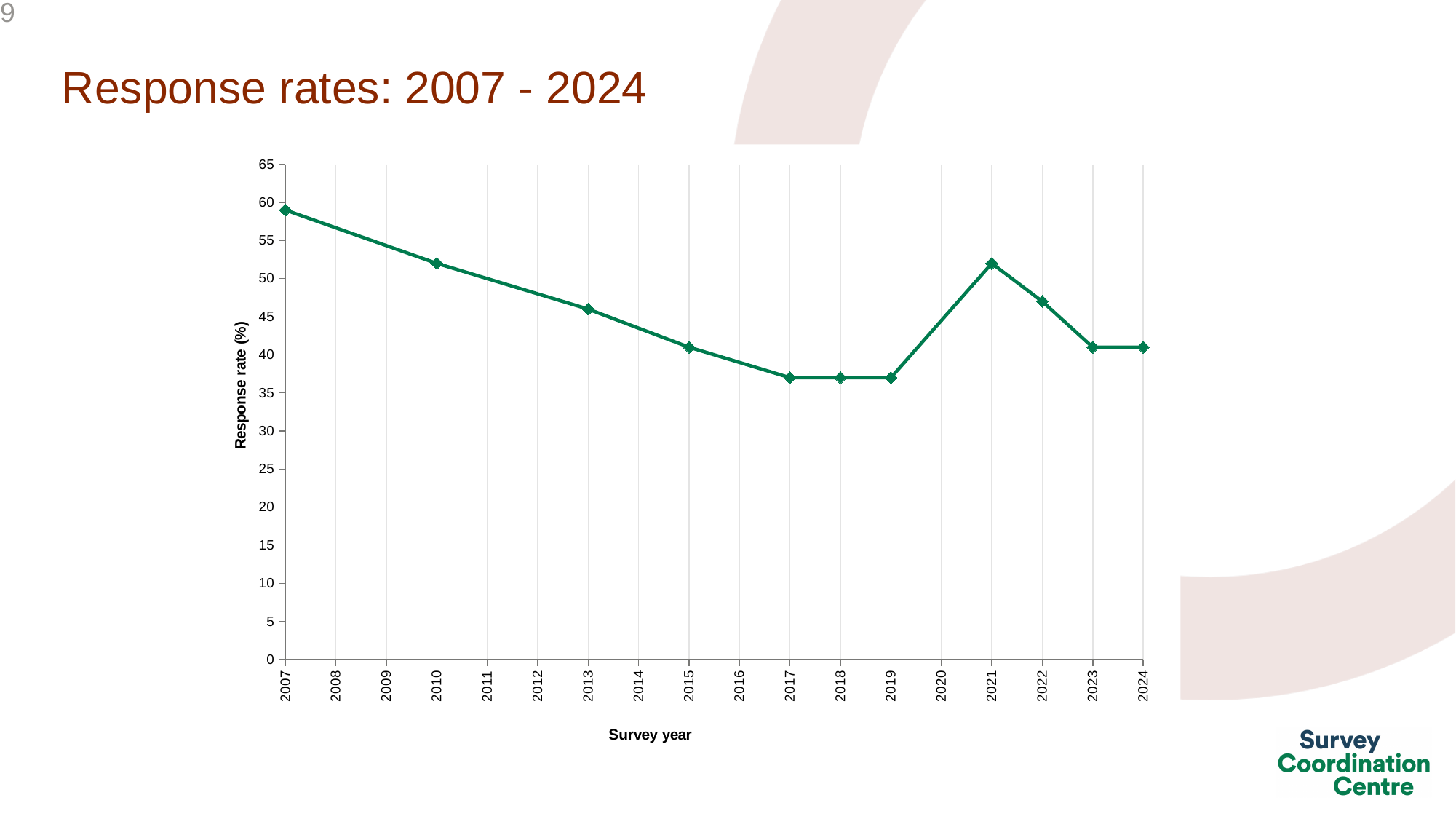
Which survey year has the highest response rate? 2007 Is the response rate for 2013 greater or less than 50? less Is the response rate for 2021 greater or less than 50? greater Is the response rate for 2007 greater or less than 55? greater What is the label on the vertical axis? Response rate (%) How many data points are plotted on the line? 11 Which year has the higher response rate, 2022 or 2023? 2022 Which year has the higher response rate, 2007 or 2021? 2007 Does the response rate rise or fall from 2007 to 2017? fall What kind of chart is shown on the slide? line chart